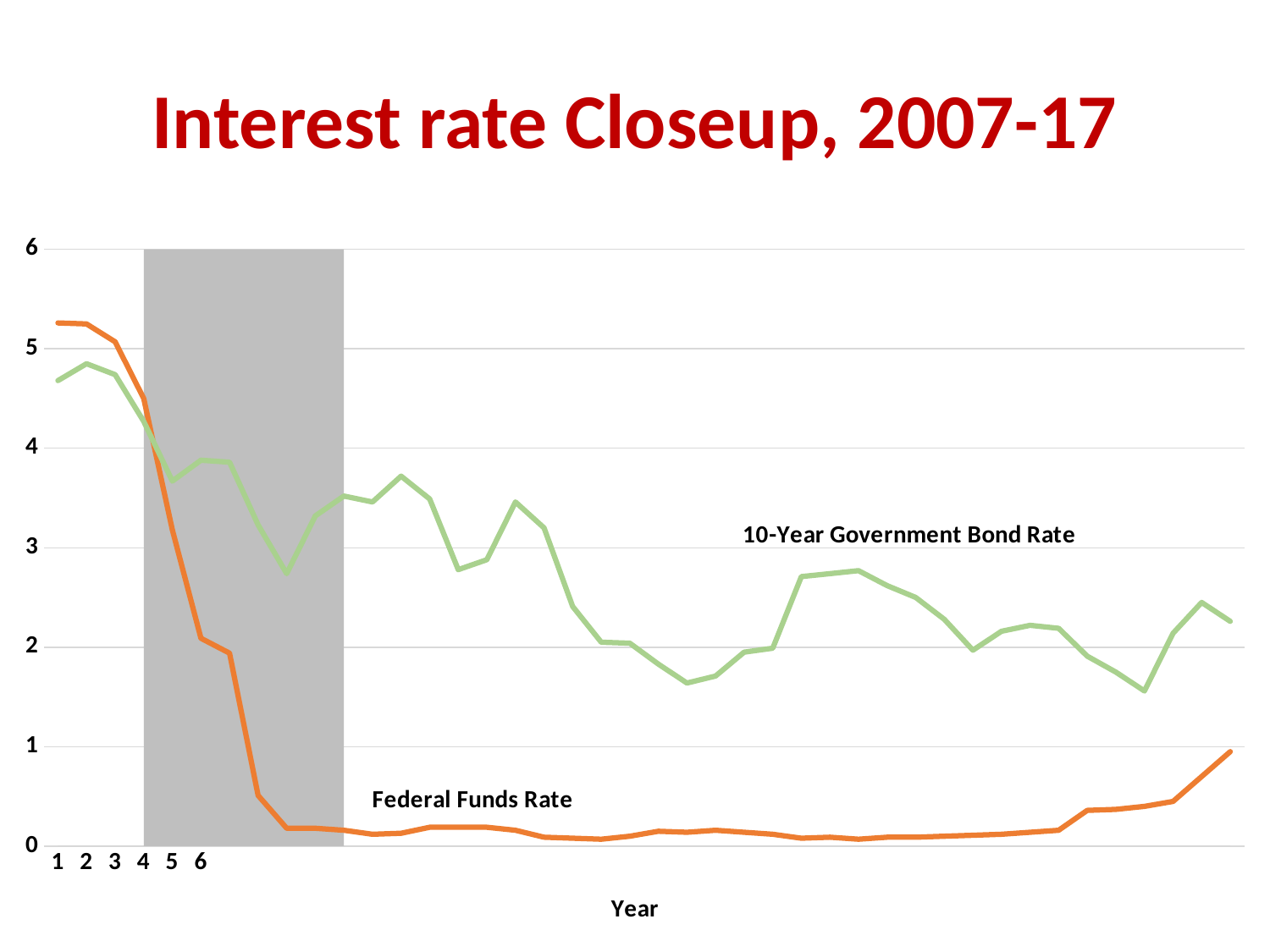
What is the title of the chart on the slide? Interest rate Closeup, 2007-17 How many series are plotted on the chart? 2 At year 6, which series has the higher value, the Federal Funds Rate or the 10-Year Government Bond Rate? 10-Year Government Bond Rate At year 1, which series has the higher value, the Federal Funds Rate or the 10-Year Government Bond Rate? Federal Funds Rate Does the Federal Funds Rate rise or fall from year 1 to year 6? fall What kind of chart is shown on the slide? line chart Is the Federal Funds Rate at year 5 greater or less than 3? greater Which series is higher at the right-hand end of the chart? 10-Year Government Bond Rate Is the 10-Year Government Bond Rate at year 1 greater or less than 5? less Is the Federal Funds Rate at year 1 greater or less than 5? greater What is the label of the x axis? Year